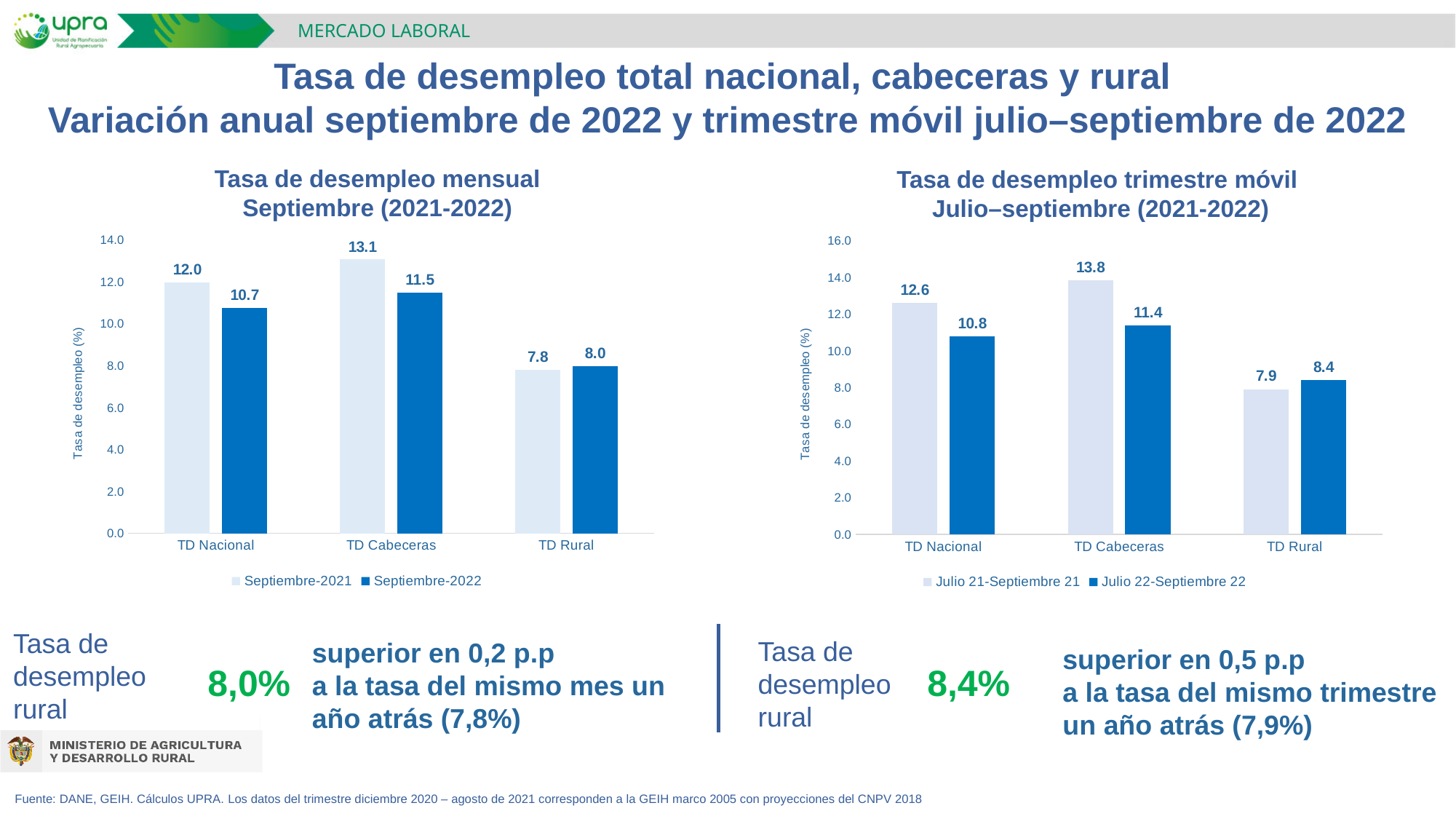
In the left chart (Tasa de desempleo mensual Septiembre), what is the value for TD Nacional in Septiembre-2022? 10.7 What kind of chart is the left chart (Tasa de desempleo mensual Septiembre)? Bar chart In the right chart (Tasa de desempleo trimestre móvil), which category has the highest value for Julio 21-Septiembre 21? TD Cabeceras In the right chart (Tasa de desempleo trimestre móvil), what is the difference between the Julio 21-Septiembre 21 and Julio 22-Septiembre 22 values for TD Nacional? 1.8 In the left chart (Tasa de desempleo mensual Septiembre), which category has the lowest value for Septiembre-2022? TD Rural In the left chart (Tasa de desempleo mensual Septiembre), what is the difference between the Septiembre-2021 and Septiembre-2022 values for TD Cabeceras? 1.6 What is the y-axis label of the right chart (Tasa de desempleo trimestre móvil)? Tasa de desempleo (%) How many series does the legend of the right chart (Tasa de desempleo trimestre móvil) list? 2 How many categories are shown on the x axis of the left chart (Tasa de desempleo mensual Septiembre)? 3 In the right chart (Tasa de desempleo trimestre móvil), which is larger for TD Rural: Julio 21-Septiembre 21 or Julio 22-Septiembre 22? Julio 22-Septiembre 22 In the left chart (Tasa de desempleo mensual Septiembre), what is the value for TD Cabeceras in Septiembre-2021? 13.1 In the right chart (Tasa de desempleo trimestre móvil), what is the value for TD Rural in Julio 22-Septiembre 22? 8.4